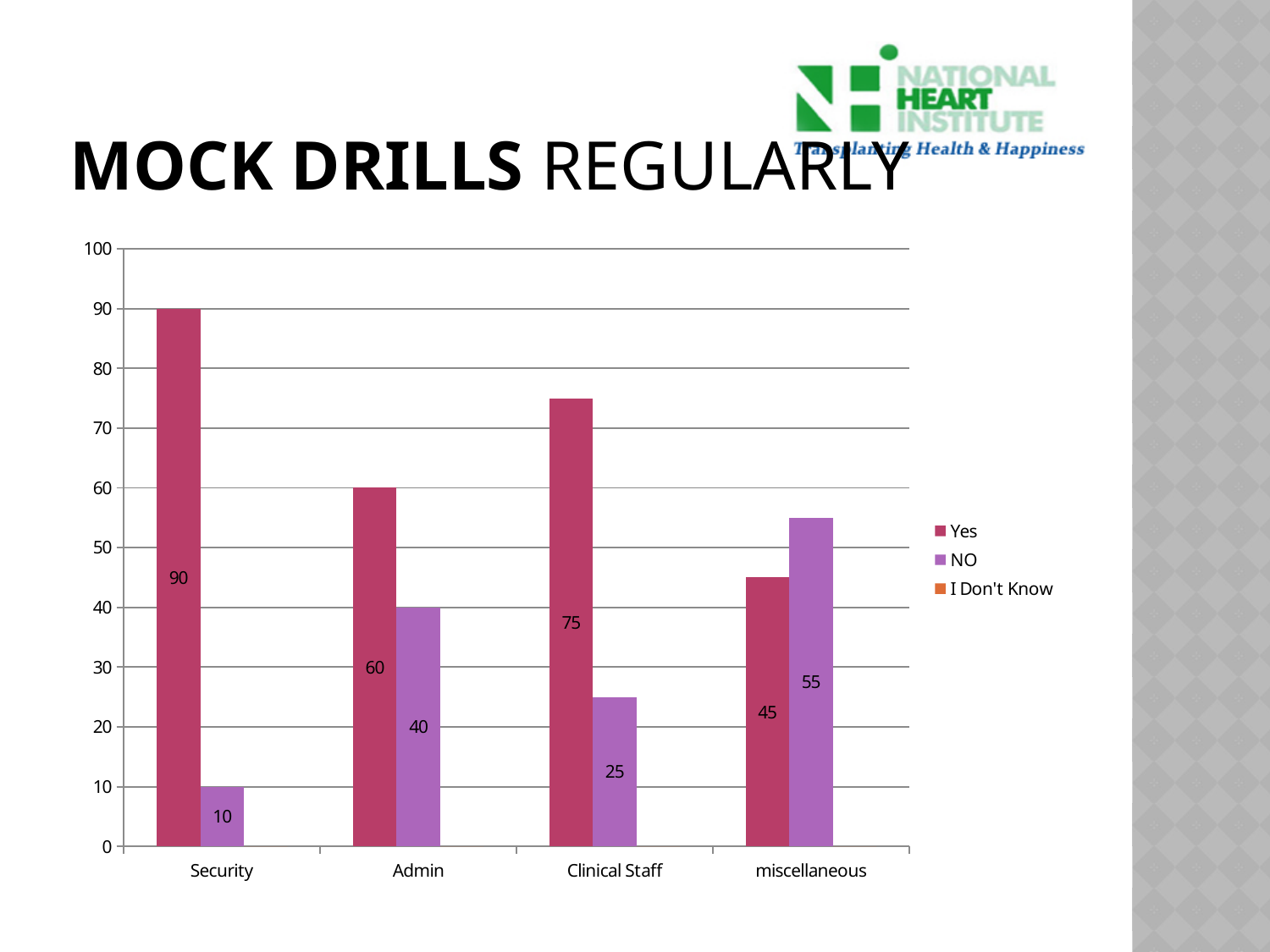
What is the NO value for Clinical Staff? 25 Which category has the highest Yes value? Security For miscellaneous, which is larger: the Yes value or the NO value? NO What is the NO value for miscellaneous? 55 What is the title of the slide? MOCK DRILLS REGULARLY What is the difference between the Yes and NO values for Admin? 20 Is the Yes value for Clinical Staff greater or less than 70? greater How many series does the legend list? 3 How many categories are shown on the x axis? 4 What kind of chart is shown on the slide? bar chart What is the Yes value for Security? 90 Which category has the lowest NO value? Security